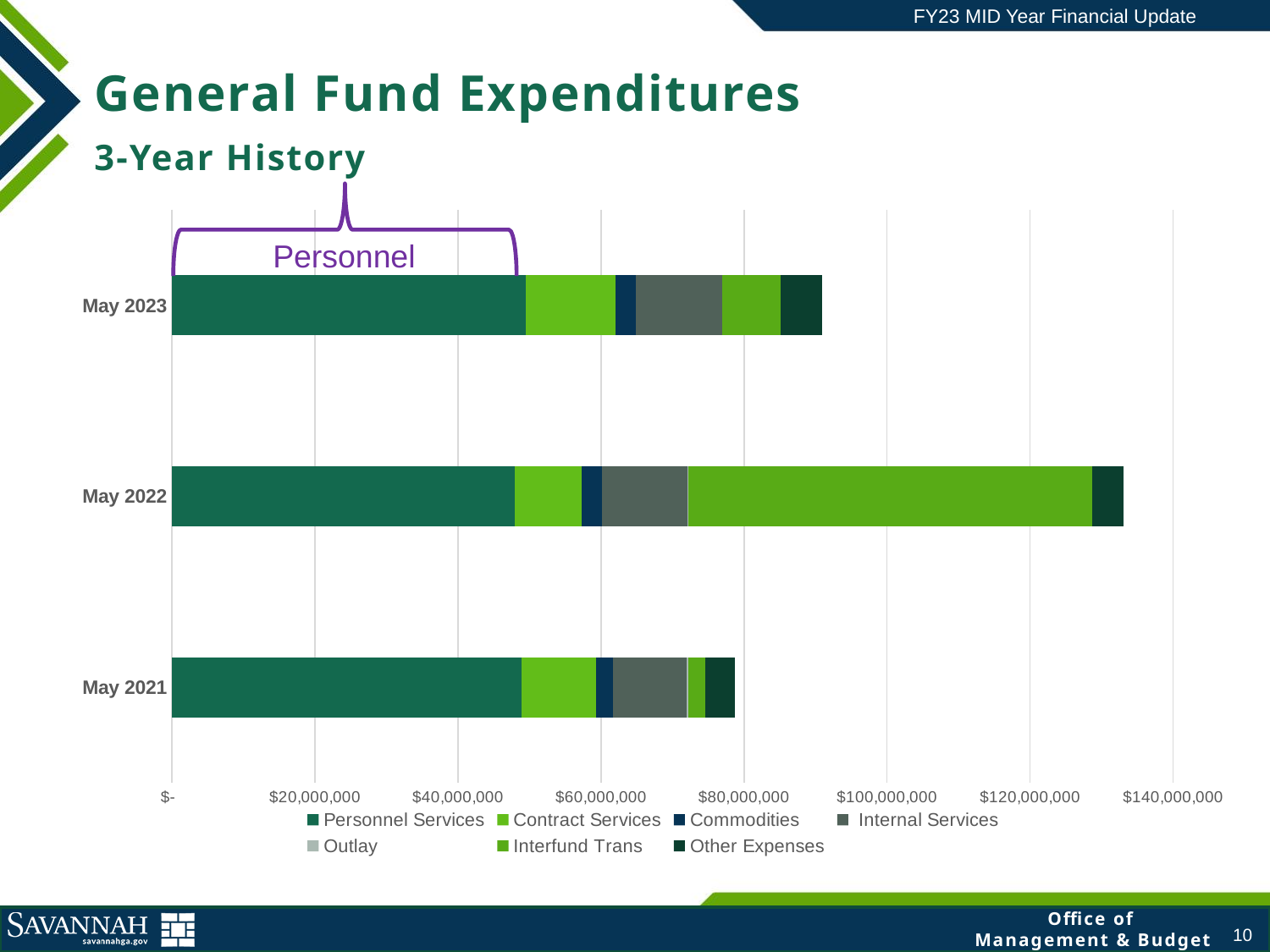
How many series does the chart legend list? 7 Is the total bar for May 2023 greater or less than $100,000,000? less Which period has the shortest total bar? May 2021 In which period is the Interfund Trans segment the largest? May 2022 Is the Personnel Services segment for May 2023 greater or less than $40,000,000? greater Is the total bar for May 2022 greater or less than $120,000,000? greater What kind of chart is shown on the slide? Stacked bar chart Which series does the purple bracket annotation on the chart label? Personnel Which period has the longest total bar? May 2022 Which is larger, the total bar for May 2022 or the total bar for May 2023? May 2022 How many time periods (categories) are plotted on the chart? 3